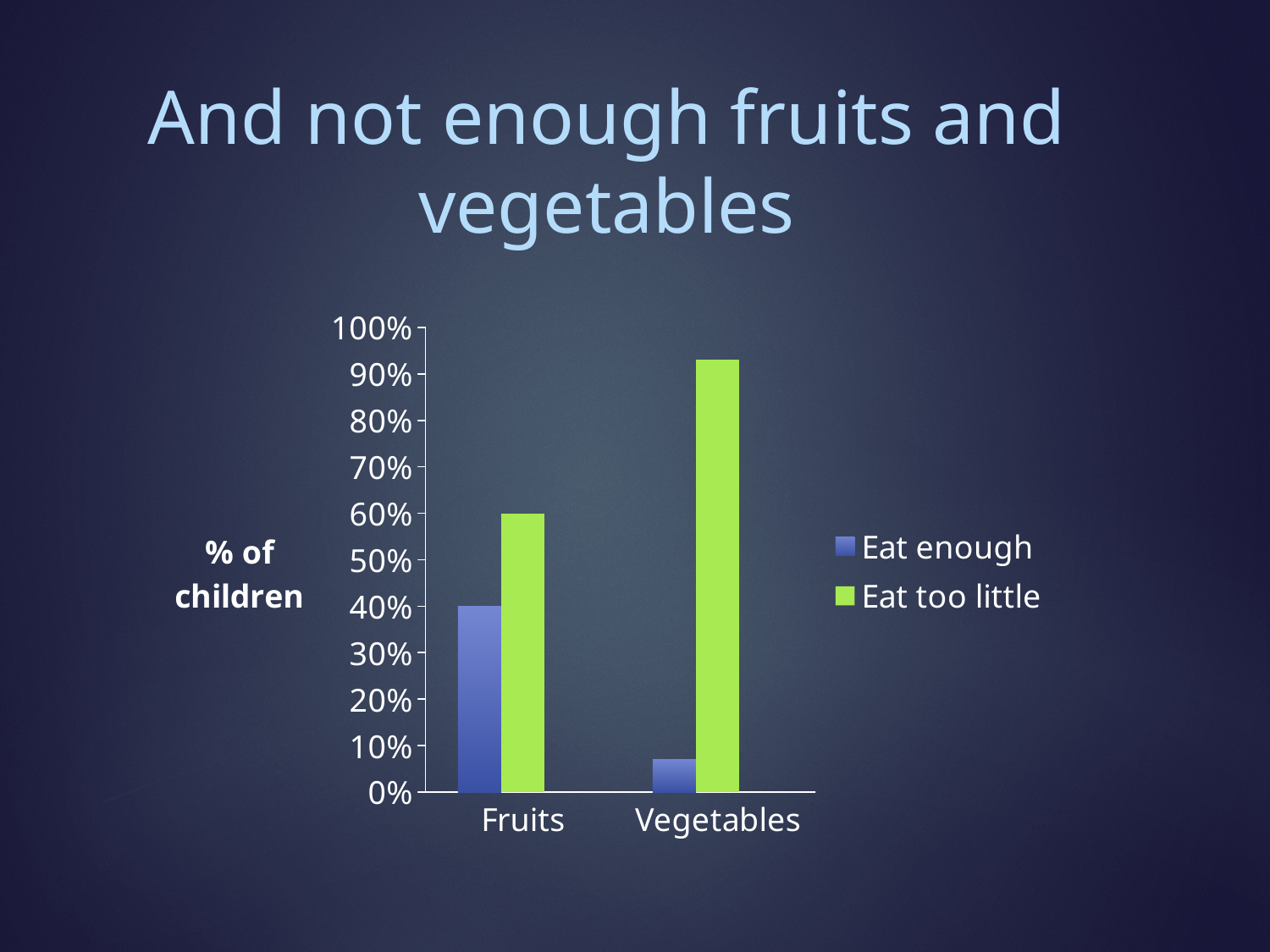
How many categories are shown on the x axis of the chart? 2 Is the value for Eat enough in the Vegetables category greater or less than 10%? less What is the value for Eat enough in the Fruits category? 40% What are the two series listed in the chart's legend? Eat enough, Eat too little Which category has the lowest value for Eat enough? Vegetables How many series does the chart's legend list? 2 What kind of chart is shown on the slide? bar chart Which category has the highest value for Eat too little? Vegetables What is the value for Eat too little in the Fruits category? 60% What is the label on the vertical axis of the chart? % of children In the Fruits category, which is larger: Eat enough or Eat too little? Eat too little Is the value for Eat too little in the Vegetables category greater or less than 90%? greater